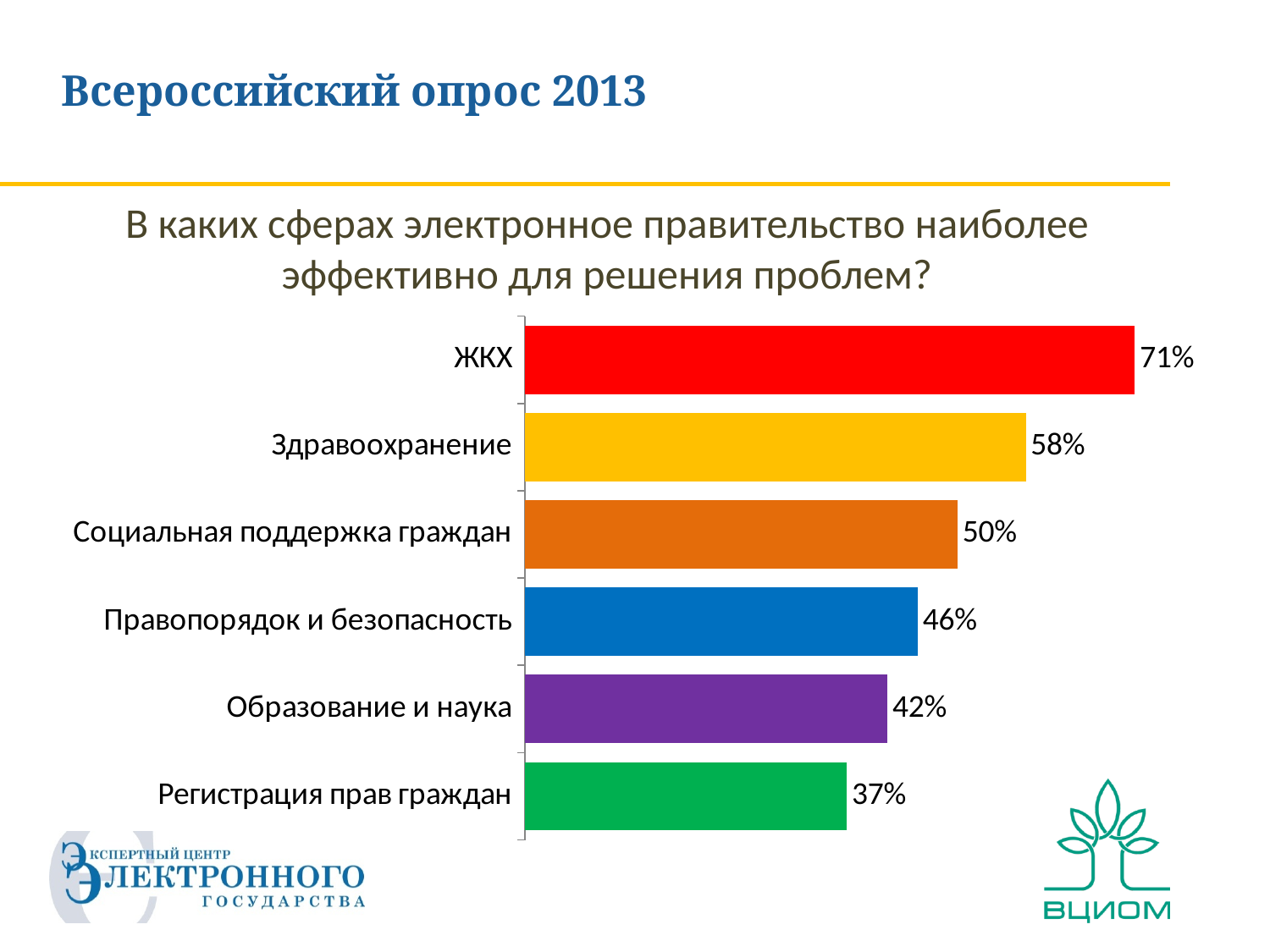
What is the value for Здравоохранение? 58% Which category has the highest value? ЖКХ What kind of chart is shown on the slide? Bar chart Which is larger, the value for Социальная поддержка граждан or the value for Правопорядок и безопасность? Социальная поддержка граждан What is the difference between the values for Образование и наука and Регистрация прав граждан? 5% Which category has the lowest value? Регистрация прав граждан What is the difference between the values for ЖКХ and Здравоохранение? 13% What is the value for ЖКХ? 71% How many categories are shown in the chart? 6 What is the value for Регистрация прав граждан? 37% What is the value for Социальная поддержка граждан? 50% What is the value for Правопорядок и безопасность? 46%